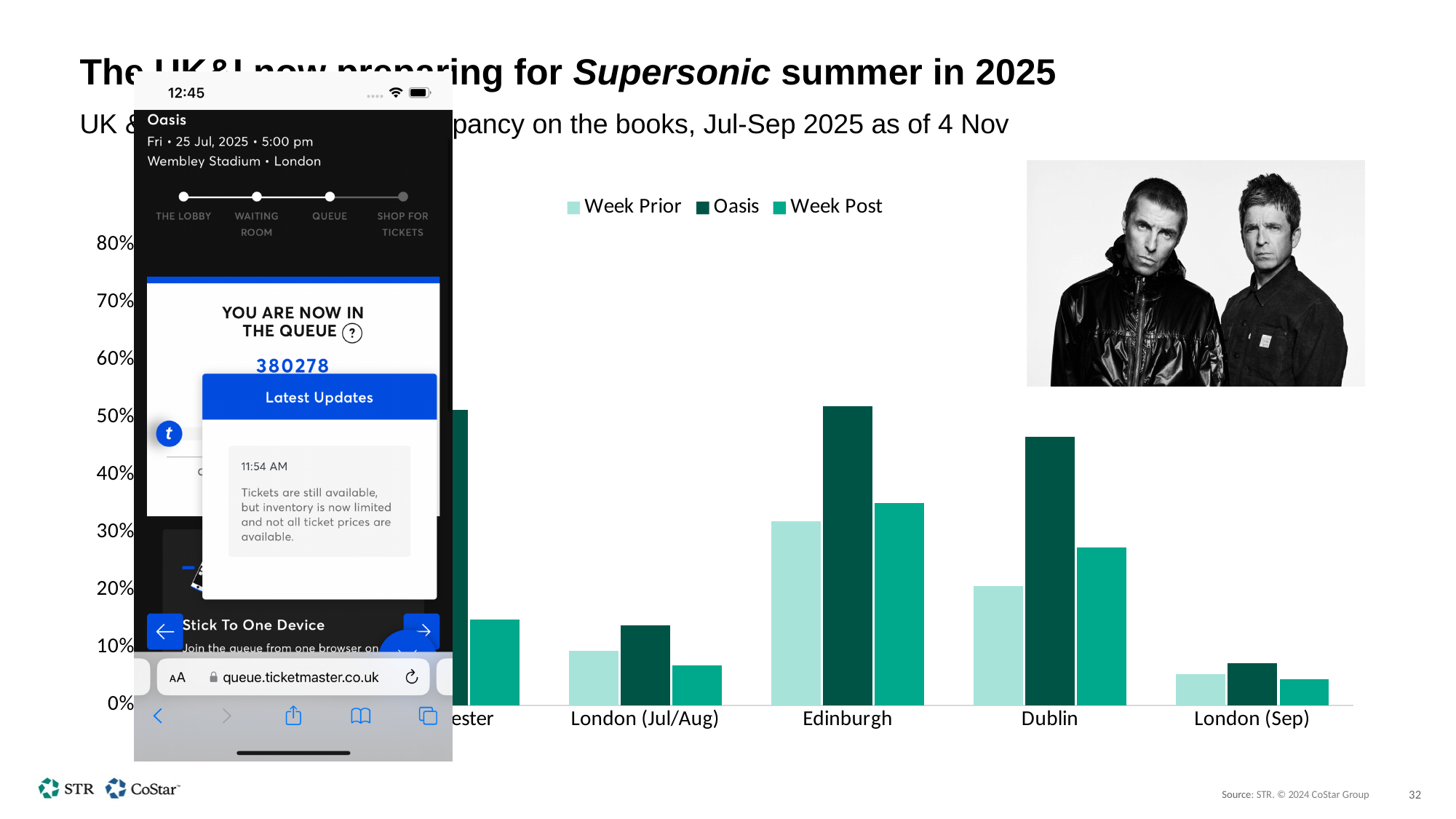
Among London (Jul/Aug), Edinburgh, Dublin and London (Sep), which has the lowest Oasis value? London (Sep) Is the Week Prior value for London (Sep) greater or less than 10%? less Is the Oasis value for Dublin greater or less than 40%? greater What kind of chart is shown on the slide? bar chart For Dublin, which is larger: the Week Prior value or the Week Post value? Week Post How many series does the chart legend list? 3 Is the Oasis value for London (Jul/Aug) greater or less than 20%? less What are the three series named in the chart legend? Week Prior, Oasis, Week Post Which of Edinburgh or Dublin has the higher Oasis value? Edinburgh For London (Jul/Aug), which is larger: the Oasis value or the Week Prior value? Oasis